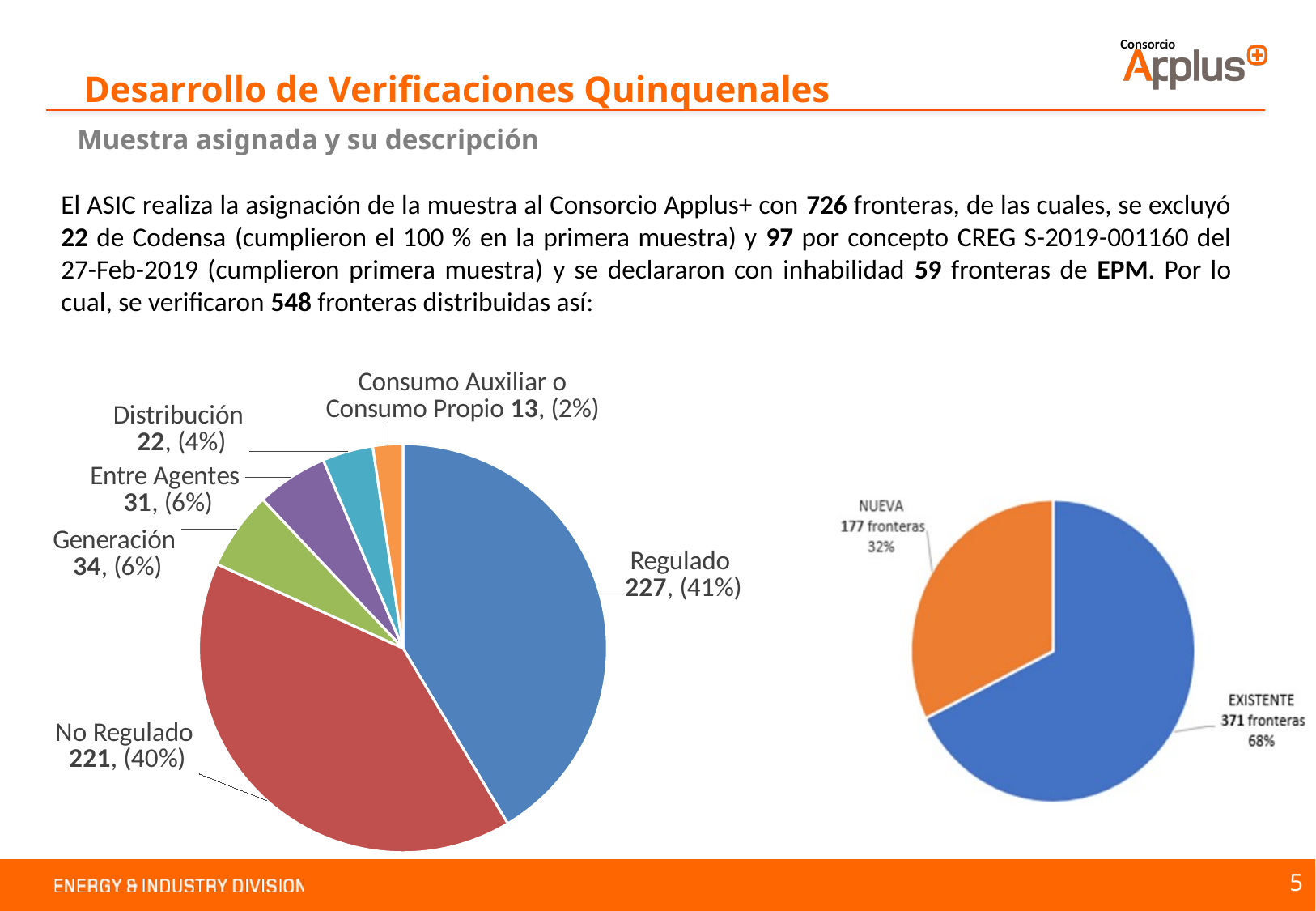
What type of chart is shown on the right side of the slide? Pie chart In the right pie chart, what share of the pie is NUEVA? 32% In the left pie chart, what is the value for Distribución? 22 In the left pie chart, what is the difference between the Regulado and No Regulado values? 6 In the right pie chart, what is the difference between EXISTENTE and NUEVA fronteras? 194 In the right pie chart, how many fronteras are EXISTENTE? 371 fronteras In the left pie chart, which category has the largest slice? Regulado In the left pie chart, what share of the pie does No Regulado represent? 40% In the left pie chart, which is larger, Generación or Entre Agentes? Generación In the left pie chart, which category has the smallest slice? Consumo Auxiliar o Consumo Propio In the left pie chart, how many fronteras are in the Regulado category? 227 In the left pie chart, how many categories are shown? 6